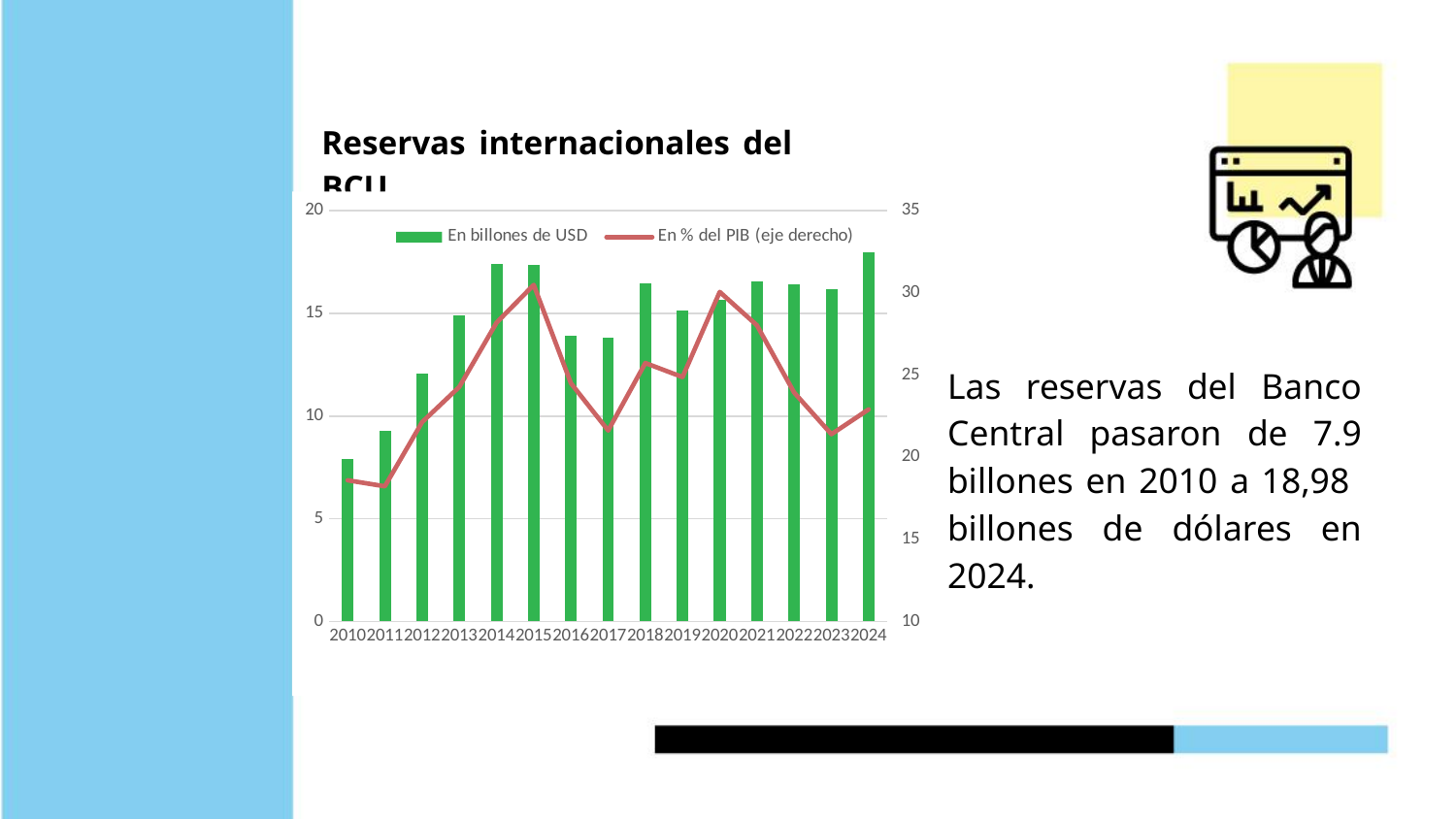
Do the 'En billones de USD' bars rise or fall from 2010 to 2014? rise Is the 'En billones de USD' value for 2016 greater or less than 15? less What type of chart is shown on the slide? A combined bar and line chart How many series does the legend list? 2 Is the 'En billones de USD' value for 2024 greater or less than 15? greater How many years are shown on the x axis? 15 Is the 'En % del PIB' value for 2017 greater or less than 25 on the right axis? less Which year has the highest bar for 'En billones de USD'? 2024 Which series is plotted on the right axis according to the legend? En % del PIB (eje derecho) Which year has the larger 'En billones de USD' bar, 2012 or 2013? 2013 Which year has the lowest bar for 'En billones de USD'? 2010